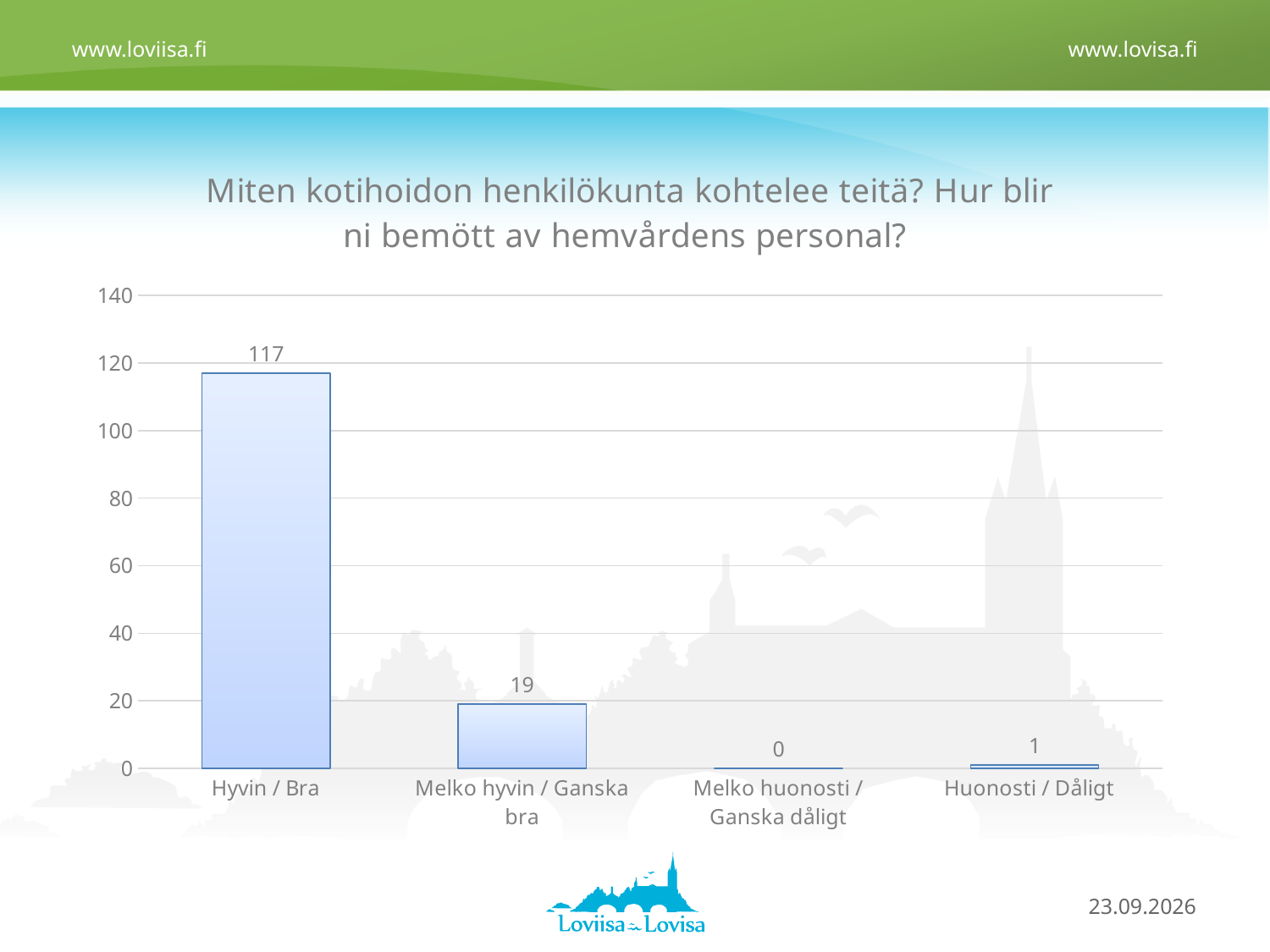
Which category has the highest value? Hyvin / Bra How many categories are shown on the x axis? 4 Which category has the lowest value? Melko huonosti / Ganska dåligt What is the value for Melko huonosti / Ganska dåligt? 0 What is the value for Melko hyvin / Ganska bra? 19 What is the value for Hyvin / Bra? 117 What is the difference between the values for Hyvin / Bra and Melko hyvin / Ganska bra? 98 Is the value for Hyvin / Bra greater or less than 100? greater What is the value for Huonosti / Dåligt? 1 What kind of chart is shown on the slide? bar chart Which is larger, the value for Melko hyvin / Ganska bra or the value for Huonosti / Dåligt? Melko hyvin / Ganska bra